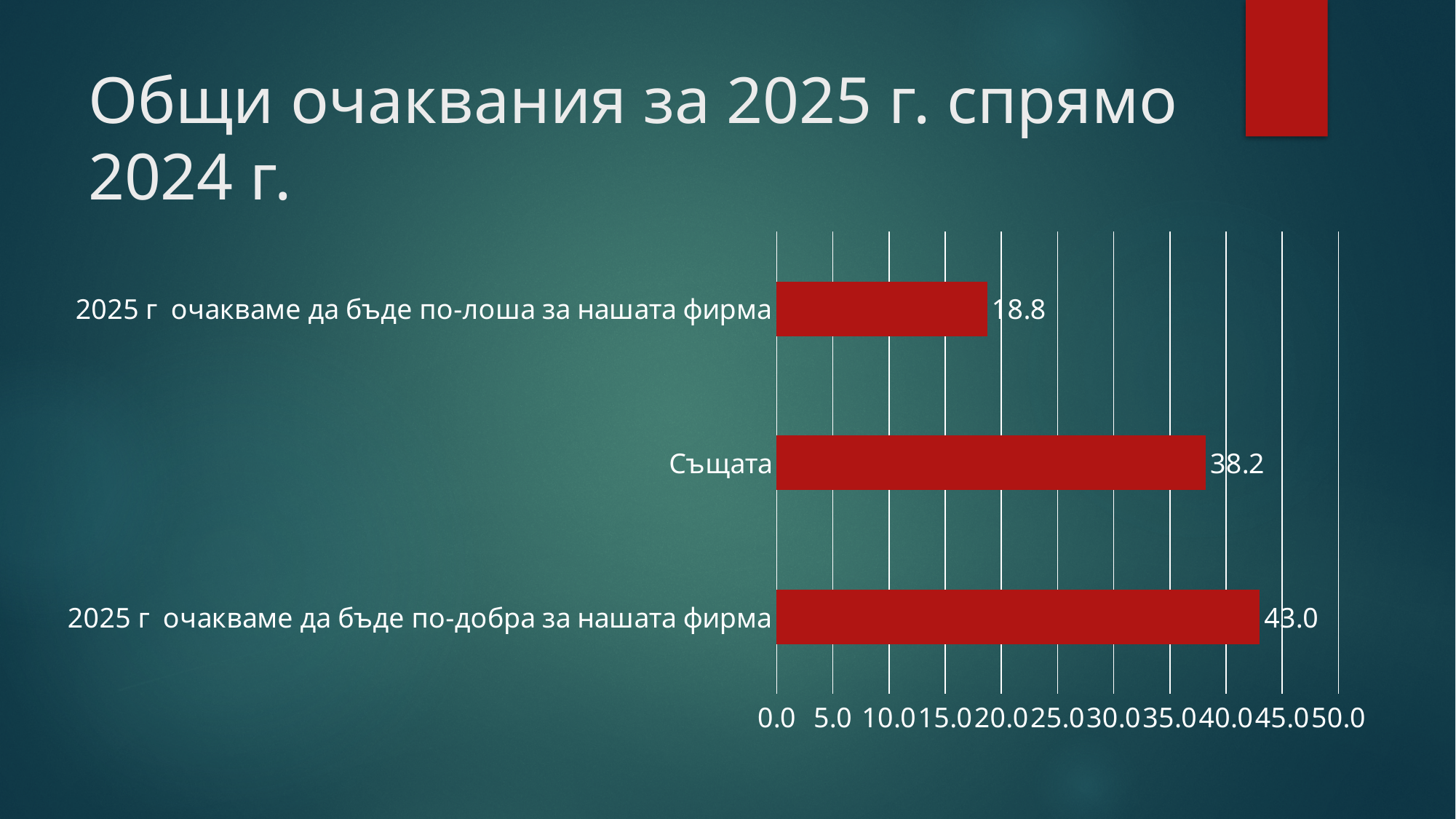
What is the value for "Същата"? 38.2 What is the difference between the values for "2025 г очакваме да бъде по-добра за нашата фирма" and "Същата"? 4.8 Is the value for "Същата" greater or less than 40.0? less What is the difference between the values for "Същата" and "2025 г очакваме да бъде по-лоша за нашата фирма"? 19.4 How many categories are shown in the chart? 3 What is the value for "2025 г очакваме да бъде по-лоша за нашата фирма"? 18.8 What is the value for "2025 г очакваме да бъде по-добра за нашата фирма"? 43.0 Which category has the lowest value? 2025 г очакваме да бъде по-лоша за нашата фирма Which category has the highest value? 2025 г очакваме да бъде по-добра за нашата фирма What is the title of the slide? Общи очаквания за 2025 г. спрямо 2024 г. What kind of chart is shown on the slide? bar chart Which is larger: the value for "Същата" or the value for "2025 г очакваме да бъде по-лоша за нашата фирма"? Същата